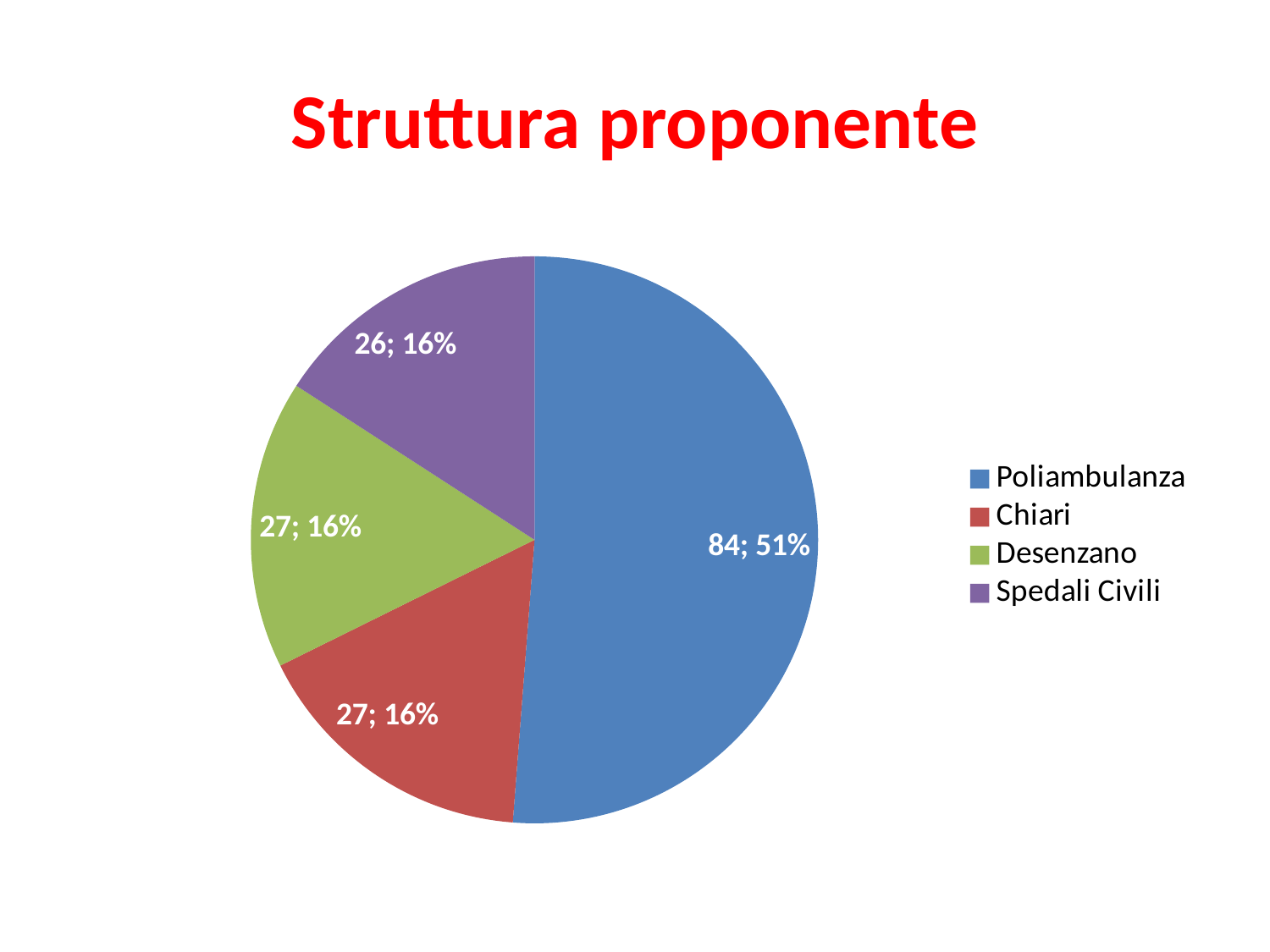
What percentage share does Poliambulanza have? 51% Which category has the smallest value? Spedali Civili Which is larger, the value for Poliambulanza or the value for Chiari? Poliambulanza What is the value shown for Spedali Civili? 26 What percentage share does Chiari have? 16% What is the difference between the values for Poliambulanza and Desenzano? 57 What is the value shown for Poliambulanza? 84 What is the title of the chart? Struttura proponente How many entries does the legend list? 4 What kind of chart is shown on the slide? pie chart How many slices does the pie chart have? 4 Which category has the largest slice? Poliambulanza